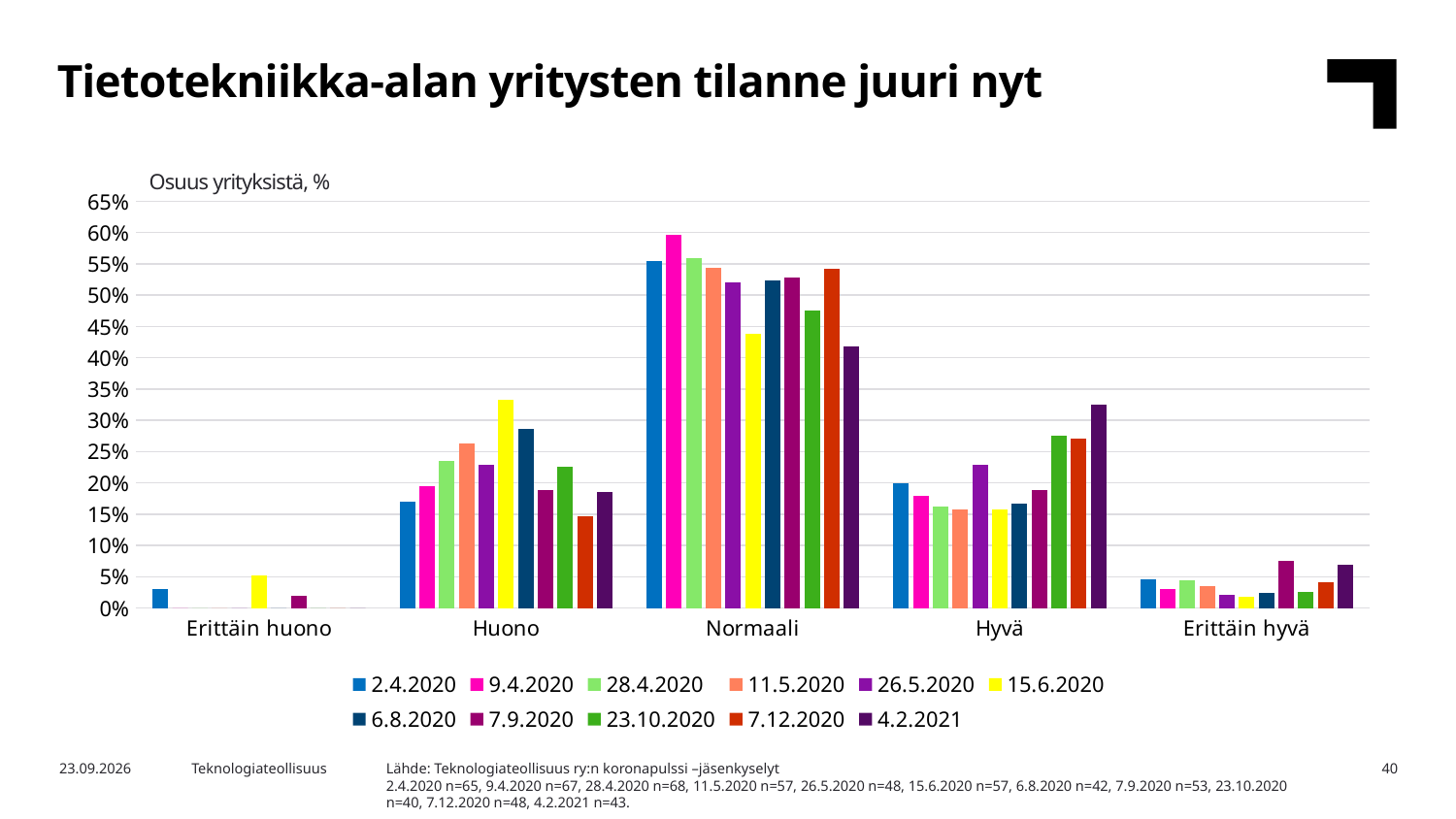
Is the value for 4.2.2021 in the Normaali category greater or less than 45%? less Is the value for 9.4.2020 in the Normaali category greater or less than 55%? greater How many series does the chart's legend list? 11 What kind of chart is shown on the slide? bar chart How many categories are shown on the x axis of the chart? 5 Is the value for 15.6.2020 in the Huono category greater or less than 30%? greater In the Huono category, which series has the lowest value? 7.12.2020 Which category has the tallest bars in the chart? Normaali In the Hyvä category, which is larger: the value for 4.2.2021 or the value for 2.4.2020? 4.2.2021 In the Erittäin huono category, which is larger: the value for 15.6.2020 or the value for 2.4.2020? 15.6.2020 What is the label shown above the y axis of the chart? Osuus yrityksistä, %